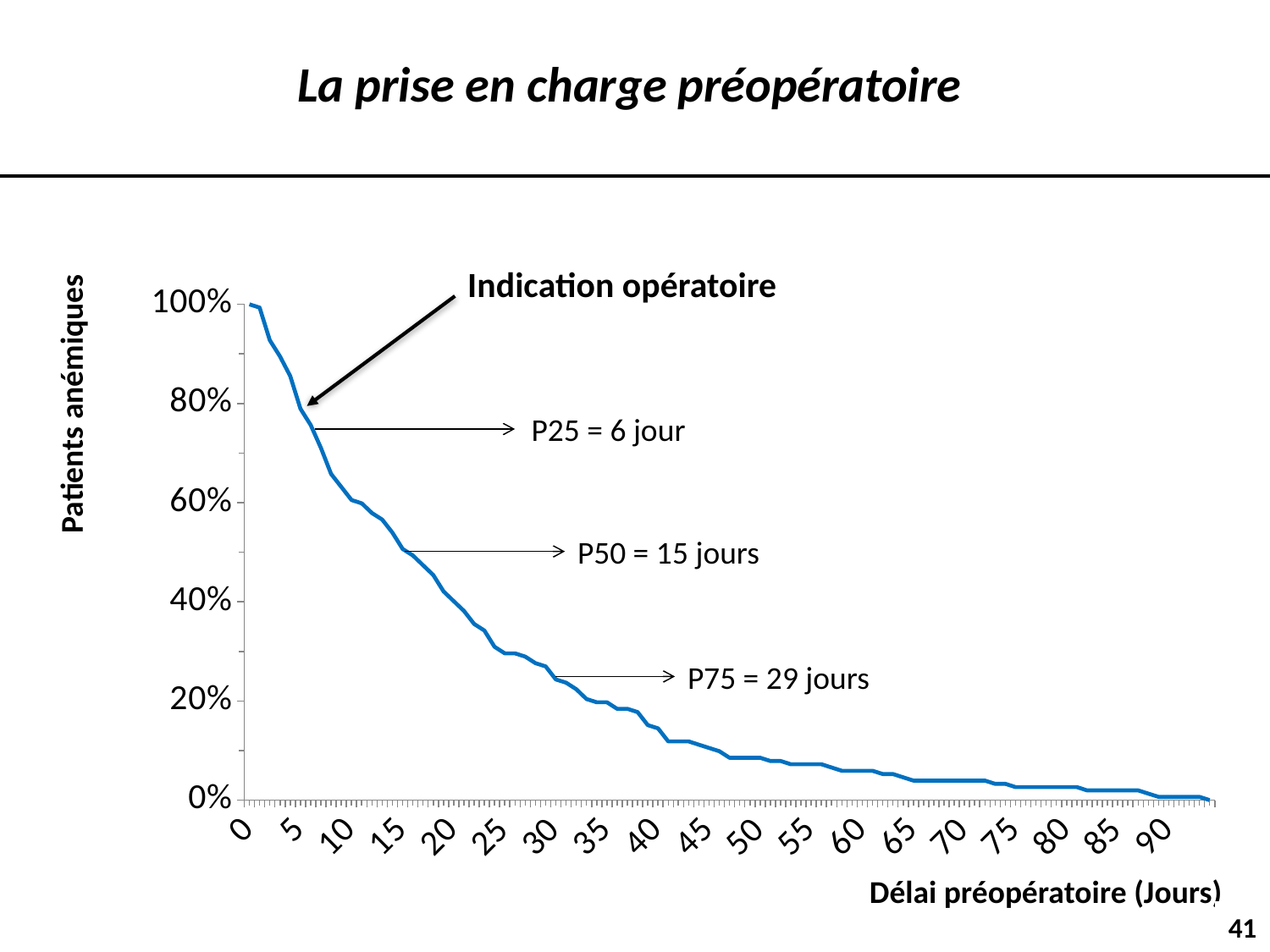
What is the value of the curve at a delay of 0 days? 100% What kind of chart is shown on the slide? line chart According to the annotation, what is the P75 preoperative delay? 29 jours Is the value of the curve at 60 days greater or less than 20%? less Is the value of the curve at 50 days greater or less than 20%? less According to the annotation, what is the P50 (median) preoperative delay? 15 jours Do the values rise or fall as the preoperative delay increases along the x axis? fall According to the annotation, what is the P25 preoperative delay? 6 jour What is the label of the y axis? Patients anémiques What is the label of the x axis? Délai préopératoire (Jours) Which is larger, the value of the curve at 10 days or at 30 days? 10 days